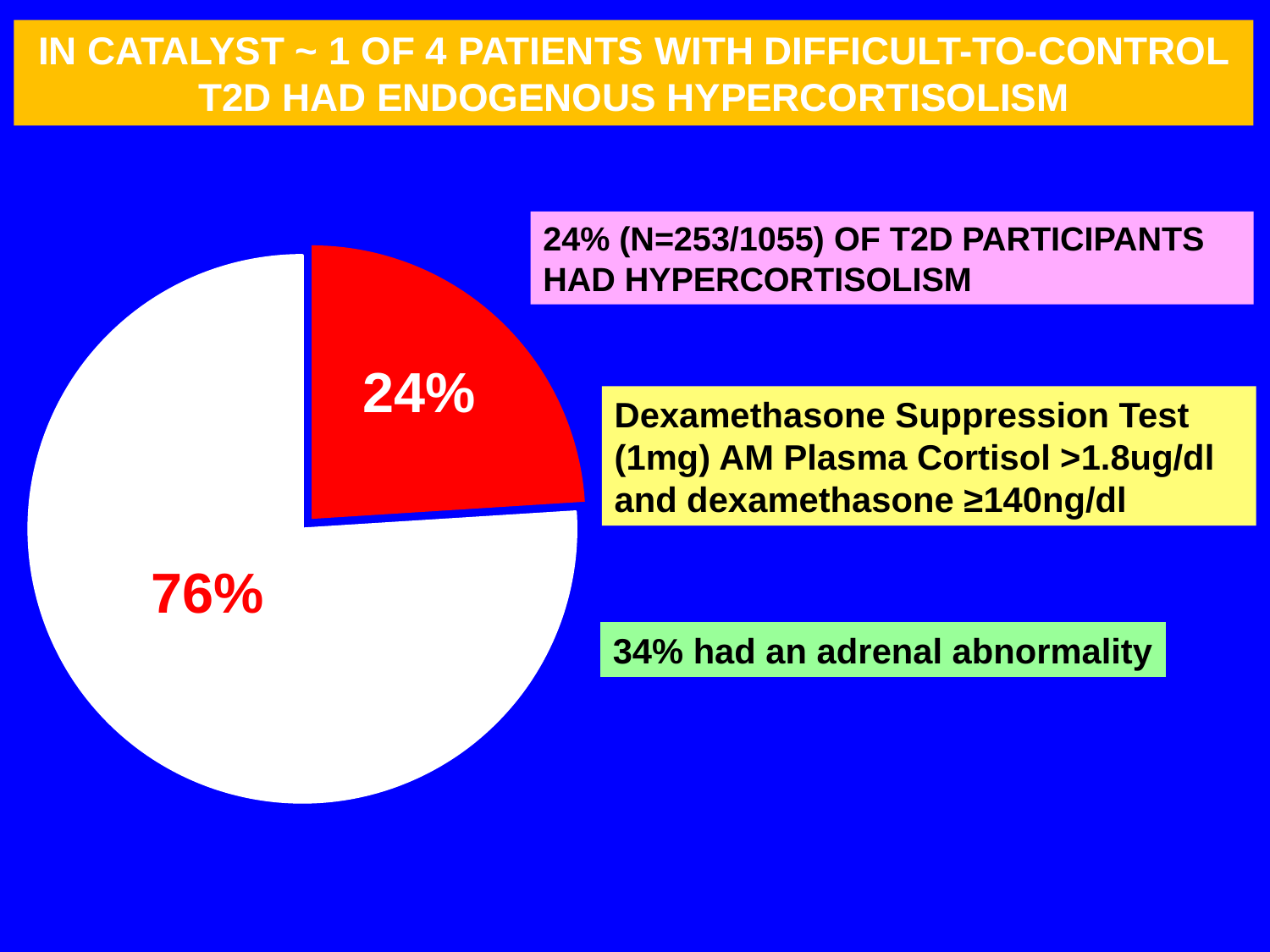
Does the pie chart include a legend? No Which slice of the pie is the smallest? the red slice (24%) What kind of chart is shown on the slide? pie chart According to the slide, how many participants (N) does the 24% slice correspond to? 253/1055 What colour is the slice representing the 24% of T2D participants with hypercortisolism? red What is the total of the two slice percentages shown on the pie chart? 100% Which slice of the pie is the largest? the white slice (76%) What share of the pie does the white slice represent? 76% How many slices does the pie chart have? 2 What share of the pie does the red slice represent? 24% What is the difference in percentage points between the white slice and the red slice? 52 Which is larger, the red slice or the white slice? the white slice